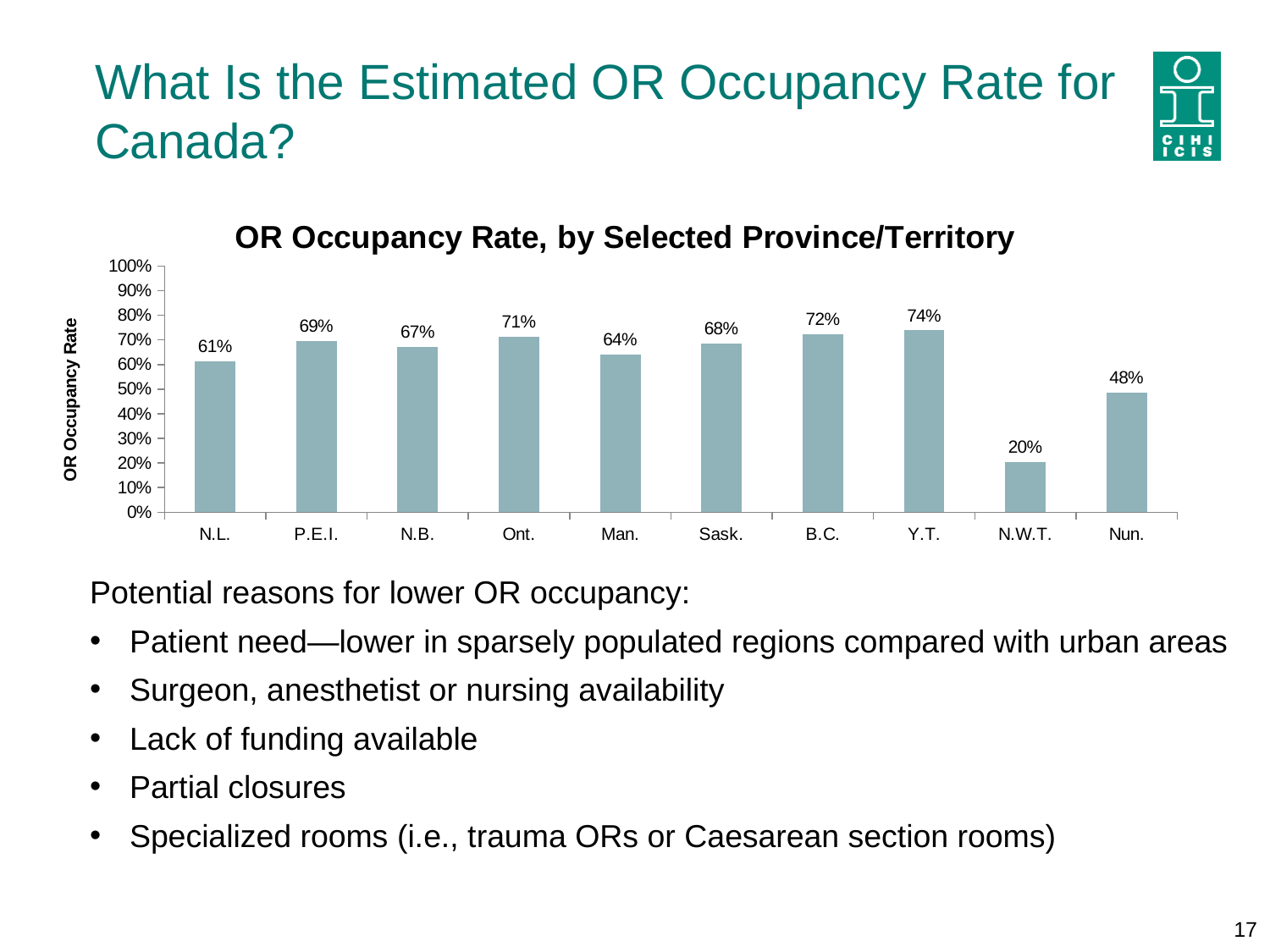
What is the OR occupancy rate for Nun.? 48% What kind of chart is shown on the slide? Bar chart What is the OR occupancy rate for Ont.? 71% Which province/territory has the lowest OR occupancy rate? N.W.T. What is the difference between the OR occupancy rates of P.E.I. and N.L.? 8% How many provinces/territories are shown in the chart? 10 Which has a higher OR occupancy rate, B.C. or Man.? B.C. Which province/territory has the highest OR occupancy rate? Y.T. Is the OR occupancy rate for Nun. greater or less than 50%? less What is the title of the chart? OR Occupancy Rate, by Selected Province/Territory What is the difference between the OR occupancy rates of Y.T. and N.W.T.? 54% What is the OR occupancy rate for N.W.T.? 20%